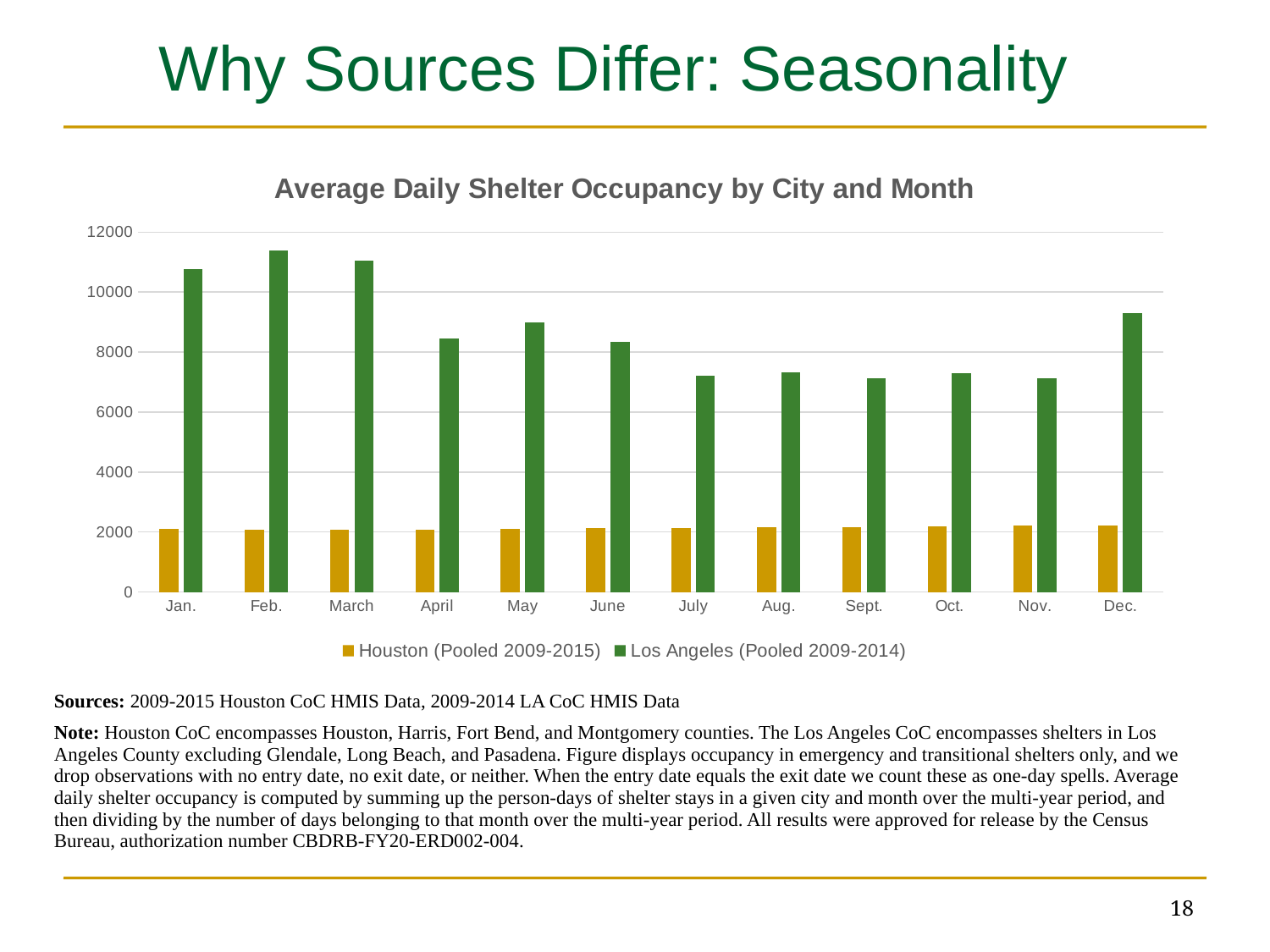
Is the Los Angeles value for Jan. greater or less than 10000? greater How many months are shown on the x axis? 12 What is the title of the chart? Average Daily Shelter Occupancy by City and Month Do the Los Angeles values rise or fall from Jan. to July? fall Which is larger in Jan., the Houston value or the Los Angeles value? Los Angeles How many series does the legend list? 2 What kind of chart is shown on the slide? bar chart In which month is the Los Angeles average daily shelter occupancy highest? Feb. Is the Los Angeles value for Dec. greater or less than 8000? greater Which is larger, the Los Angeles value for Feb. or the Los Angeles value for April? Feb. Is the Los Angeles value for July greater or less than 8000? less